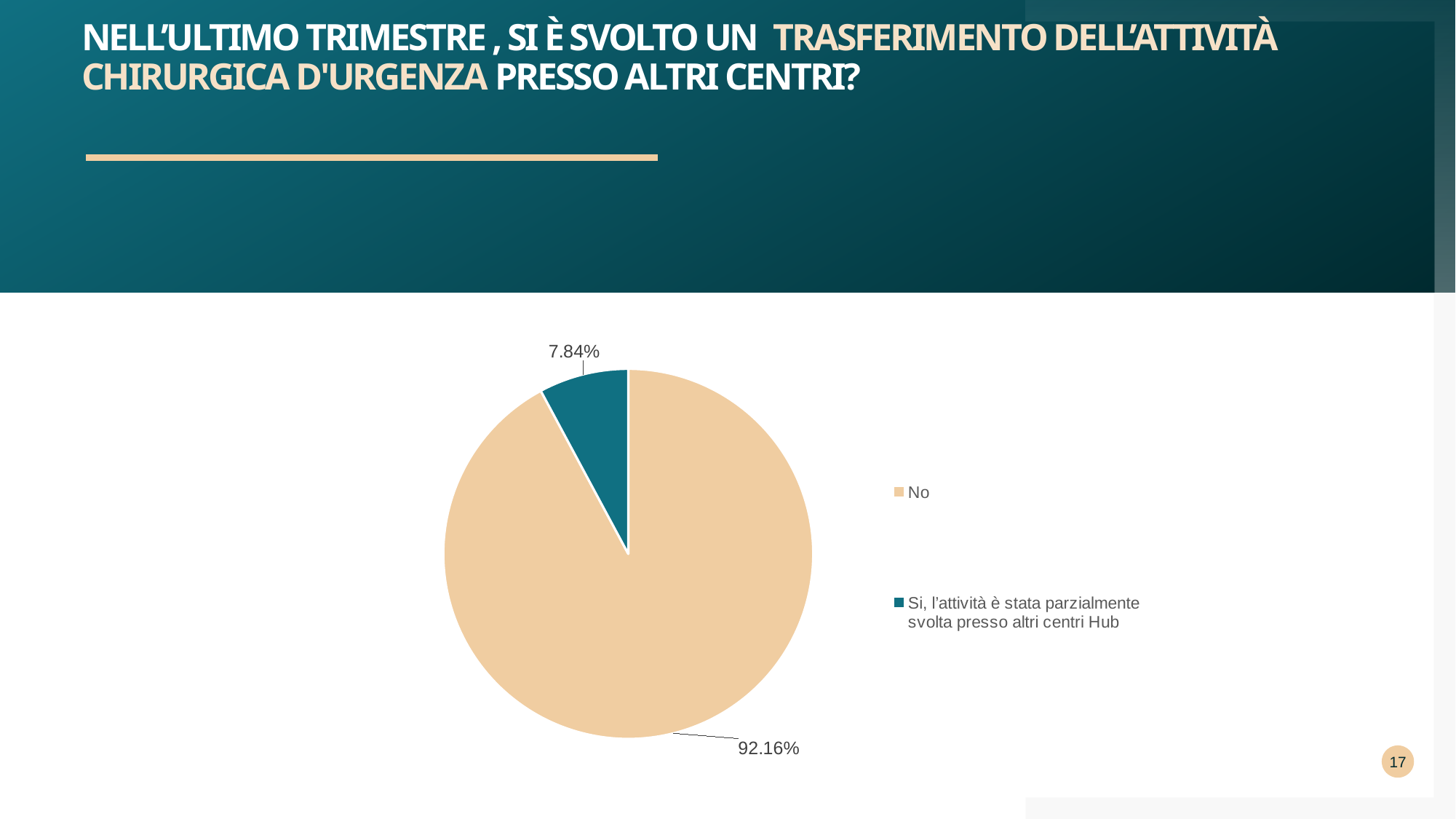
What is the difference in percentage points between the "No" slice and the "Si" slice? 84.32 What kind of chart is shown on the slide? pie chart How many slices does the pie chart have? 2 Which is larger, the "No" slice or the "Si, l'attività è stata parzialmente svolta presso altri centri Hub" slice? No Which slice of the pie is the smallest? Si, l'attività è stata parzialmente svolta presso altri centri Hub Which slice of the pie is the largest? No What share of the pie does the "No" slice represent? 92.16% What colour is the "Si, l'attività è stata parzialmente svolta presso altri centri Hub" slice? teal What colour is the "No" slice in the pie chart? beige What share of the pie does the "Si, l'attività è stata parzialmente svolta presso altri centri Hub" slice represent? 7.84% Is the share of the "No" slice greater or less than 90%? greater How many entries does the legend list? 2